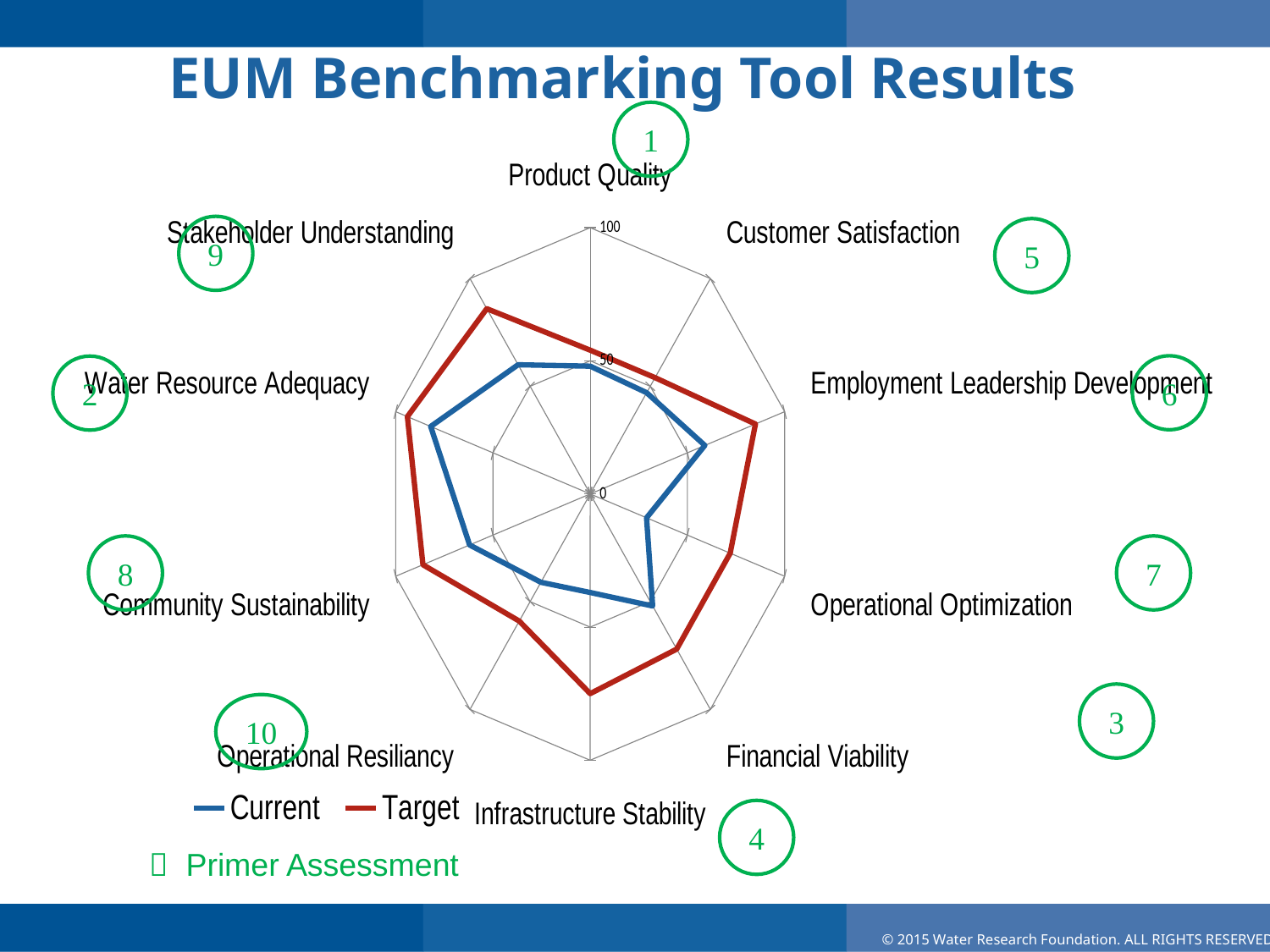
Which category has the lowest Current value? Operational Optimization Is the Current value for Operational Optimization greater or less than 50? less Is the Current value for Operational Resiliancy greater or less than 50? less Is the Target value for Stakeholder Understanding greater or less than 50? greater Which colour is used for the Target series? red For the Current series, which is larger: Water Resource Adequacy or Operational Optimization? Water Resource Adequacy How many categories (axes) does the radar chart have? 10 For Infrastructure Stability, which series has the larger value, Current or Target? Target What are the two series named in the legend? Current and Target What kind of chart is shown on the slide? radar chart How many series does the legend list? 2